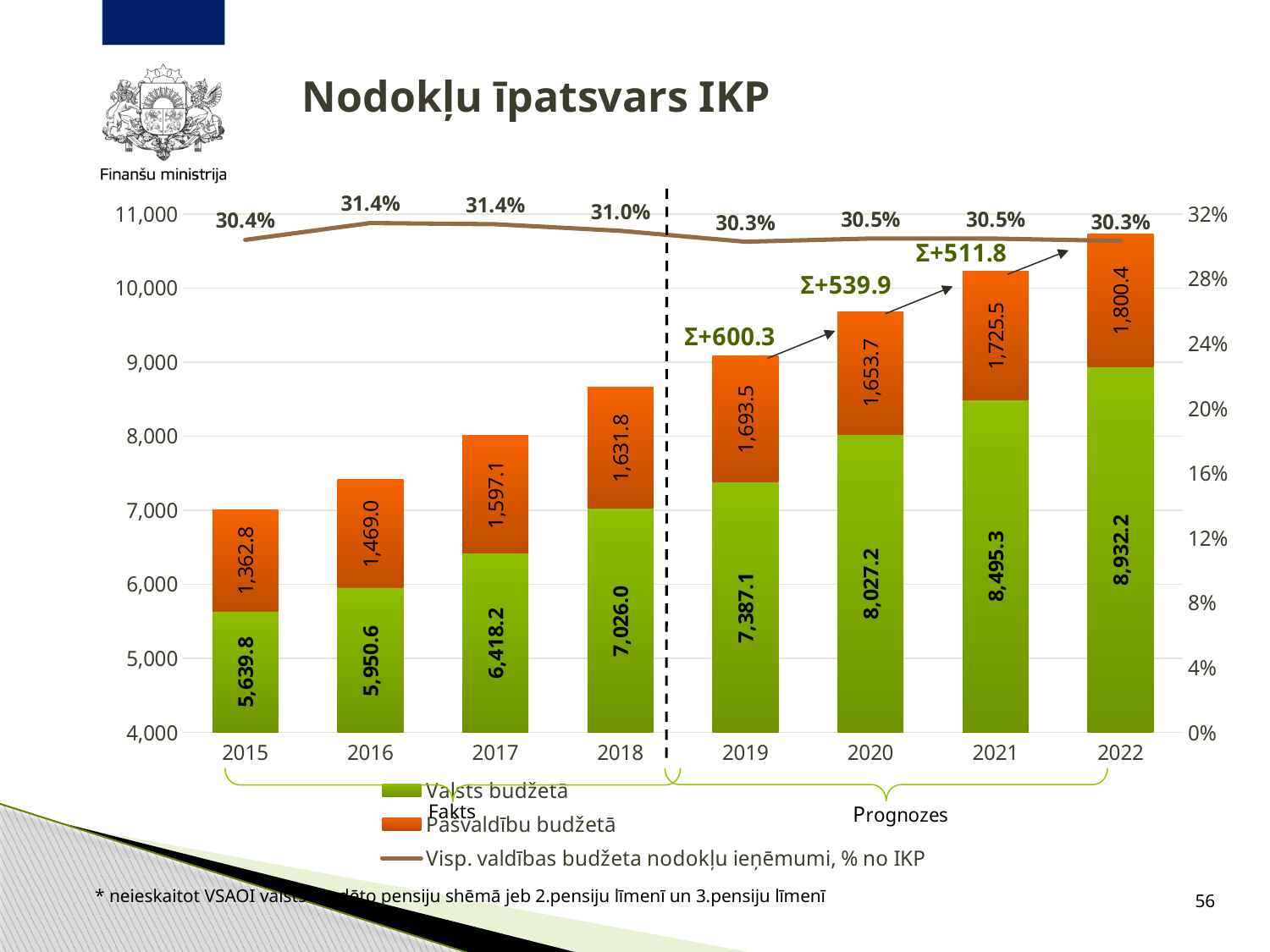
What is the total of the stacked bar for 2015? 7,002.6 What kind of chart is this? Stacked bar chart with a line What is the value for Pašvaldību budžetā in 2020? 1,653.7 In which year is the Valsts budžetā value highest? 2022 Which is larger, the Pašvaldību budžetā value for 2019 or for 2020? 2019 What is the value for Valsts budžetā in 2018? 7,026.0 How many years are shown on the x axis? 8 How many series does the legend list? 3 What percentage of IKP does the line show for 2016? 31.4% In which year is the Pašvaldību budžetā value lowest? 2015 What is the difference between the Valsts budžetā values for 2022 and 2021? 436.9 Do the Valsts budžetā values rise or fall from 2015 to 2022? Rise